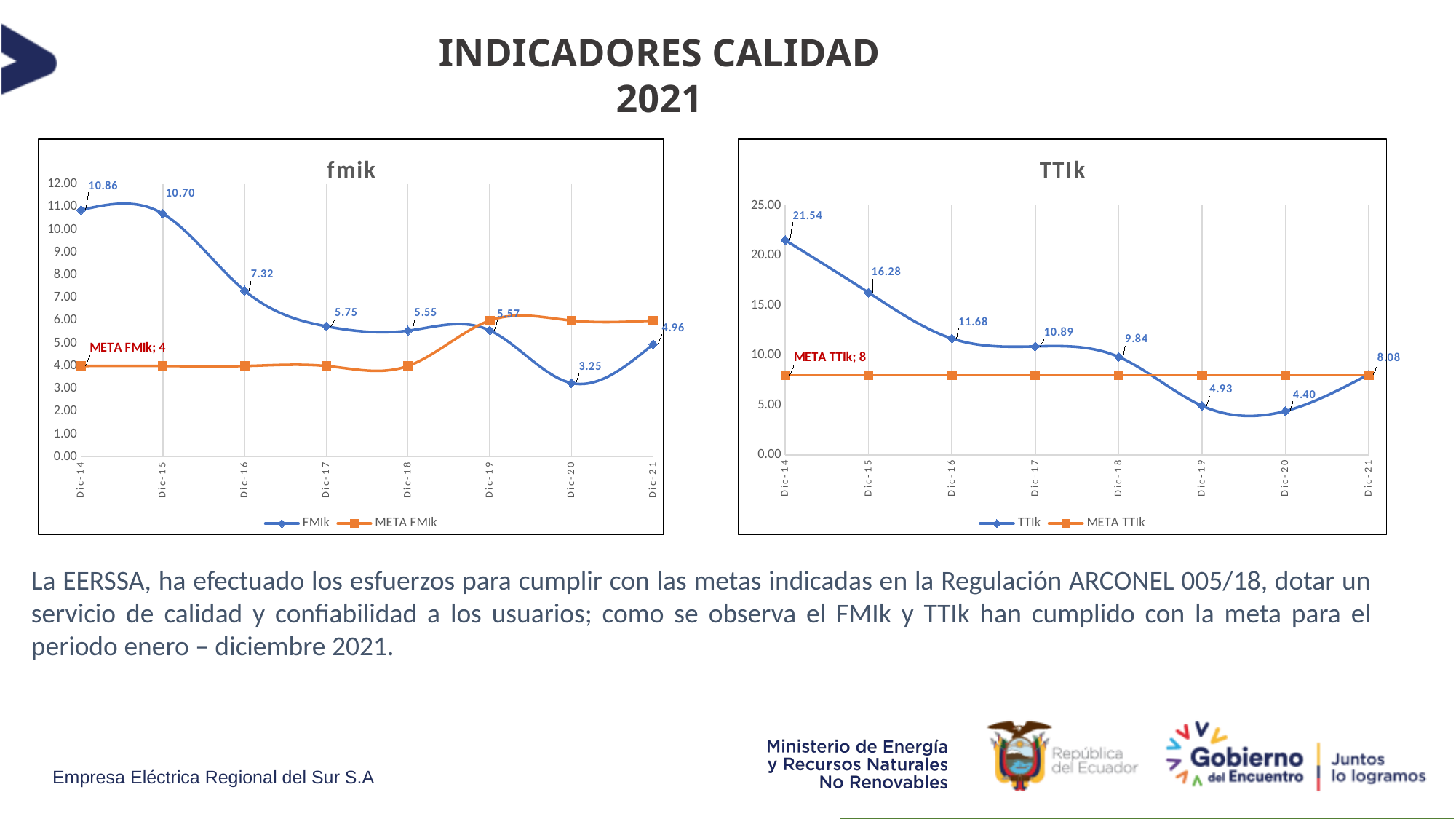
In the fmik chart, what is the FMIk value at Dic-14? 10.86 In the fmik chart, what is the FMIk value at Dic-21? 4.96 In the fmik chart, what is the FMIk value at Dic-20? 3.25 What type of chart is the fmik chart? Line chart In the TTIk chart, what is the TTIk value at Dic-21? 8.08 In the fmik chart, at which date is the FMIk value lowest? Dic-20 In the TTIk chart, what is the TTIk value at Dic-14? 21.54 In the TTIk chart, at which date is the TTIk value highest? Dic-14 In the fmik chart, what is the difference between the FMIk values at Dic-14 and Dic-15? 0.16 In the TTIk chart, which is larger: the TTIk value at Dic-16 or at Dic-17? Dic-16 How many series does the legend of the TTIk chart list? 2 In the TTIk chart, what is the difference between the TTIk values at Dic-19 and Dic-20? 0.53